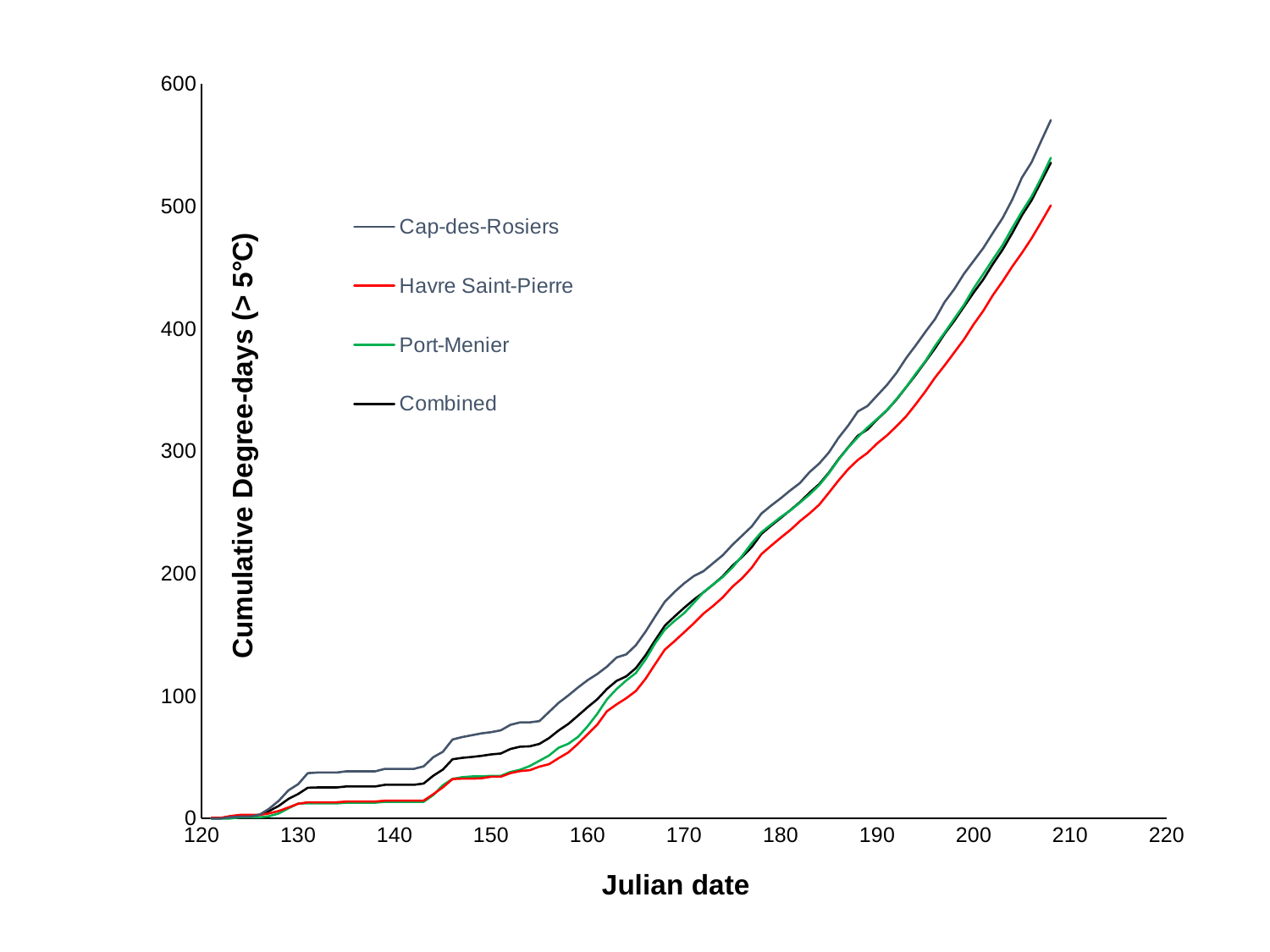
Which series has the lowest cumulative degree-days at the end of the plotted period? Havre Saint-Pierre Which series reaches the highest cumulative degree-days at the end of the plotted period? Cap-des-Rosiers Is the value for Cap-des-Rosiers at Julian date 200 greater or less than 400? greater What colour is the line for Havre Saint-Pierre? red Do the cumulative degree-day values rise or fall as the Julian date increases? rise At the end of the plotted period, which is larger: the value for Cap-des-Rosiers or the value for Havre Saint-Pierre? Cap-des-Rosiers Is the final value for Cap-des-Rosiers greater or less than 500? greater What is the title of the y axis? Cumulative Degree-days (> 5°C) How many series does the legend list? 4 What kind of chart is shown on the slide? line chart Is the value for Combined at Julian date 170 greater or less than 200? less